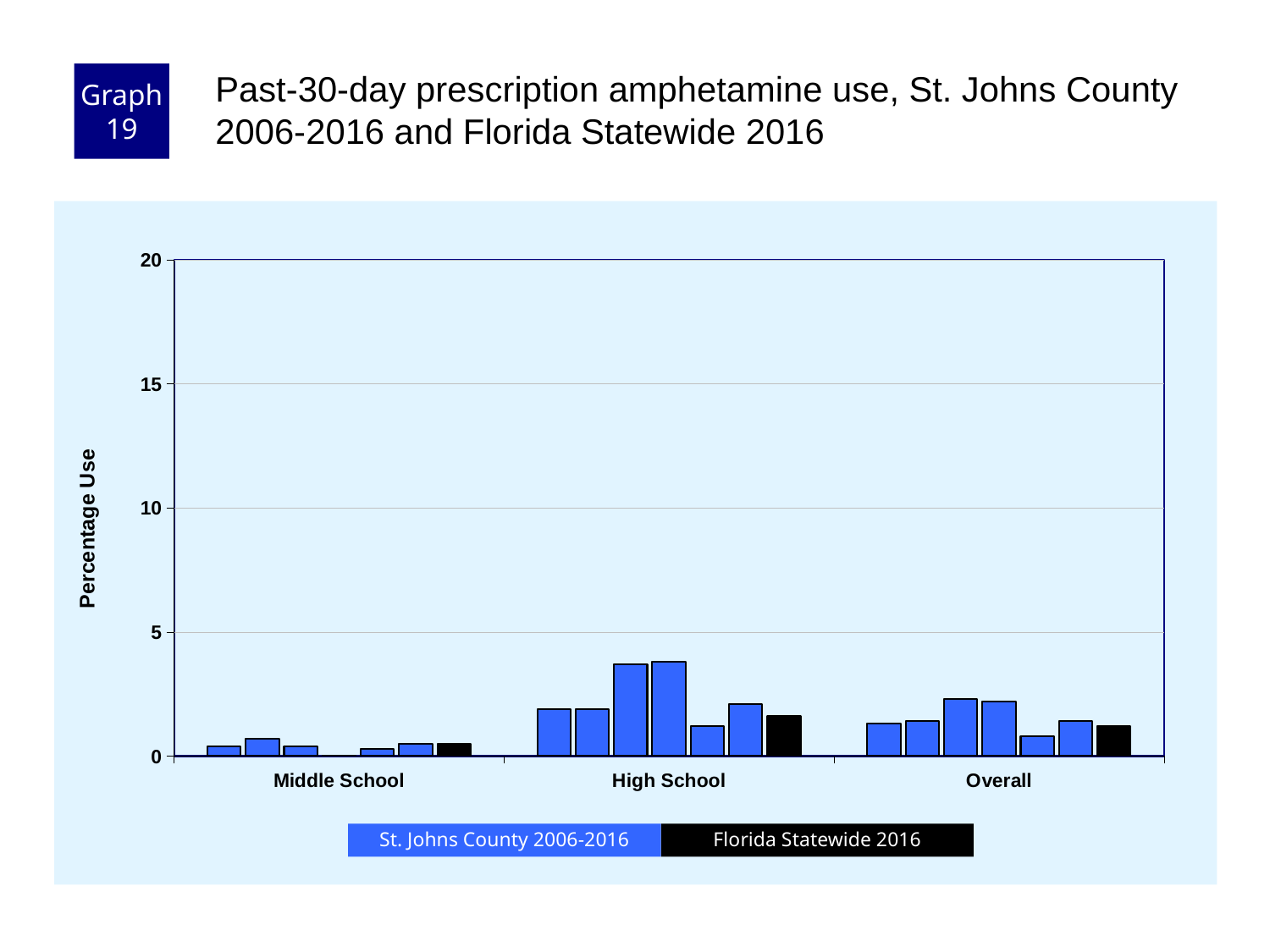
Is the Florida Statewide 2016 value for Middle School greater or less than 5? less What is the label on the y axis? Percentage Use Which series is shown in black? Florida Statewide 2016 Which is larger, the Florida Statewide 2016 value for High School or for Middle School? High School Which category has the shortest bars? Middle School Are any of the bars on the chart greater or less than 10? less What kind of chart is shown on the slide? bar chart Which category has the tallest bars? High School Which is larger, the Florida Statewide 2016 value for Overall or for Middle School? Overall How many categories are shown on the x axis? 3 Is the Florida Statewide 2016 value for High School greater or less than 5? less How many series does the legend list? 2